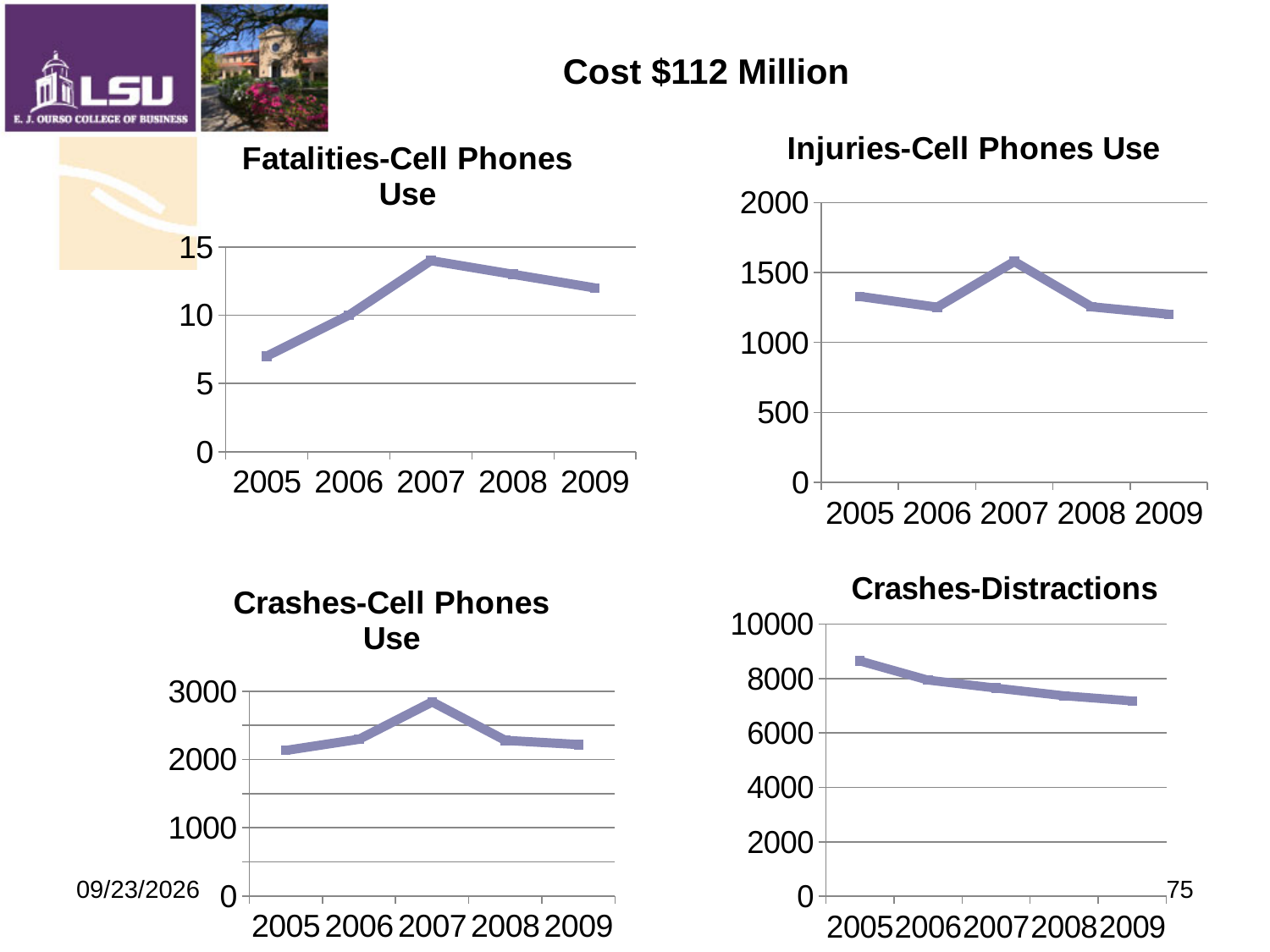
What type of chart is the Fatalities-Cell Phones Use chart? line chart In the Crashes-Cell Phones Use chart, is the value for 2005 greater or less than 2000? greater In the Fatalities-Cell Phones Use chart, which year has the lowest value? 2005 In the Crashes-Cell Phones Use chart, which year has the highest value? 2007 In the Crashes-Distractions chart, which year has the highest value? 2005 In the Crashes-Distractions chart, do the values rise or fall from 2005 to 2009? fall In the Crashes-Distractions chart, is the value for 2005 greater or less than 8000? greater In the Injuries-Cell Phones Use chart, which year has the highest value? 2007 How many years are plotted on the Injuries-Cell Phones Use chart? 5 In the Injuries-Cell Phones Use chart, is the value for 2007 greater or less than 1500? greater In the Fatalities-Cell Phones Use chart, is the value for 2009 larger or smaller than the value for 2005? larger